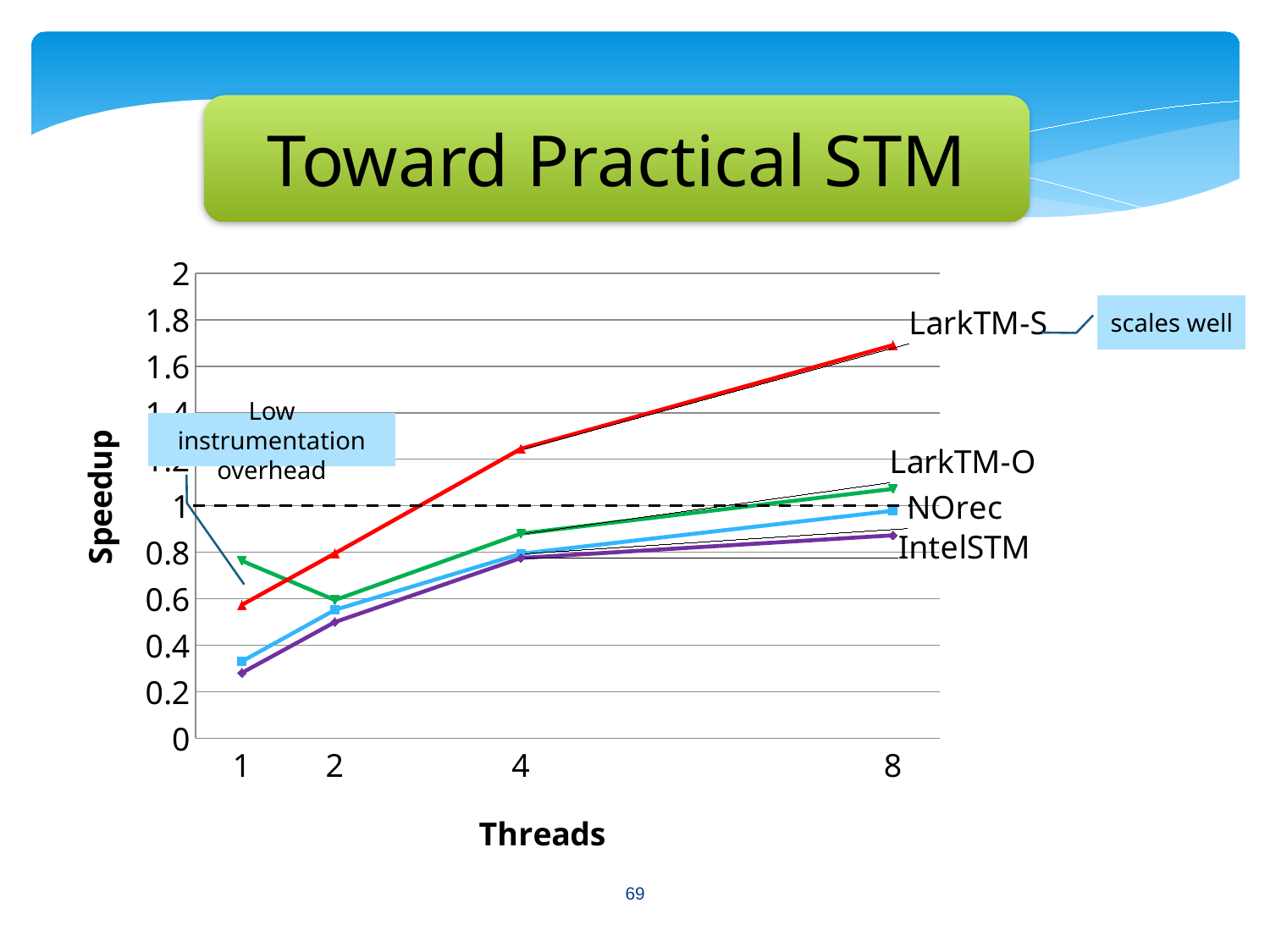
How many thread counts are plotted along the x axis? 4 At 1 thread, which has the higher speedup, LarkTM-O or LarkTM-S? LarkTM-O Is the speedup for LarkTM-S at 1 thread greater or less than 0.8? less Is the speedup for IntelSTM at 1 thread greater or less than 0.4? less What kind of chart is shown on the slide? line chart What is the title of the y axis? Speedup Does the speedup for LarkTM-S rise or fall as the number of threads increases? rises At 2 threads, which has the higher speedup, LarkTM-S or LarkTM-O? LarkTM-S Which series has the highest speedup at 8 threads? LarkTM-S How many series (lines) are labelled on the chart? 4 Which series has the lowest speedup at 1 thread? IntelSTM Is the speedup for LarkTM-S at 8 threads greater or less than 1.4? greater